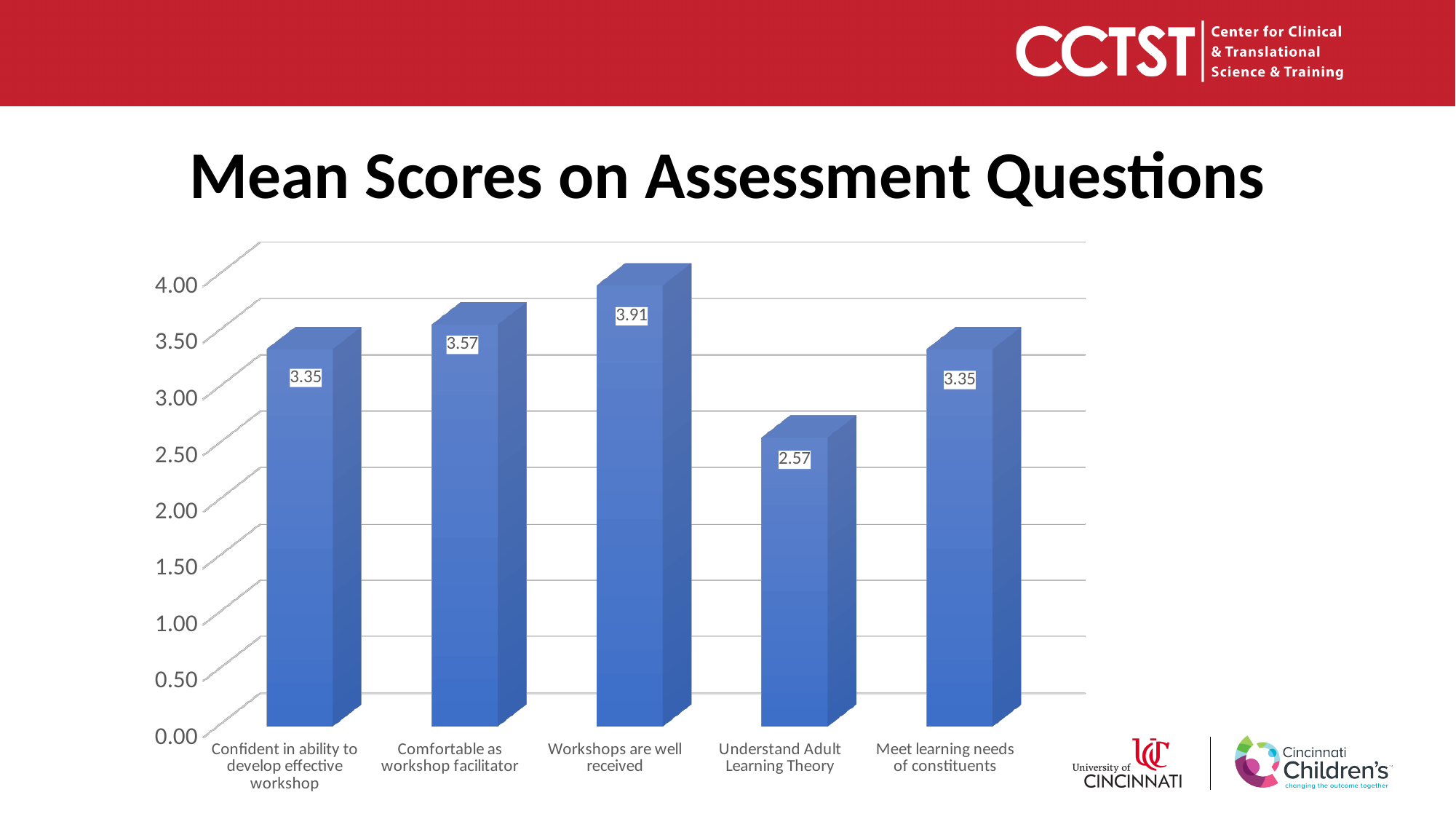
Which assessment question has the highest mean score? Workshops are well received What is the difference between the mean scores for "Workshops are well received" and "Understand Adult Learning Theory"? 1.34 What is the mean score for "Comfortable as workshop facilitator"? 3.57 Is the mean score for "Understand Adult Learning Theory" greater or less than 3.00? less How many assessment questions are shown on the chart? 5 What is the mean score for "Understand Adult Learning Theory"? 2.57 What is the difference between the mean scores for "Comfortable as workshop facilitator" and "Confident in ability to develop effective workshop"? 0.22 What is the mean score for "Workshops are well received"? 3.91 Which assessment question has the lowest mean score? Understand Adult Learning Theory What is the title of the chart? Mean Scores on Assessment Questions What kind of chart is shown on the slide? Bar chart Which has a higher mean score: "Comfortable as workshop facilitator" or "Meet learning needs of constituents"? Comfortable as workshop facilitator